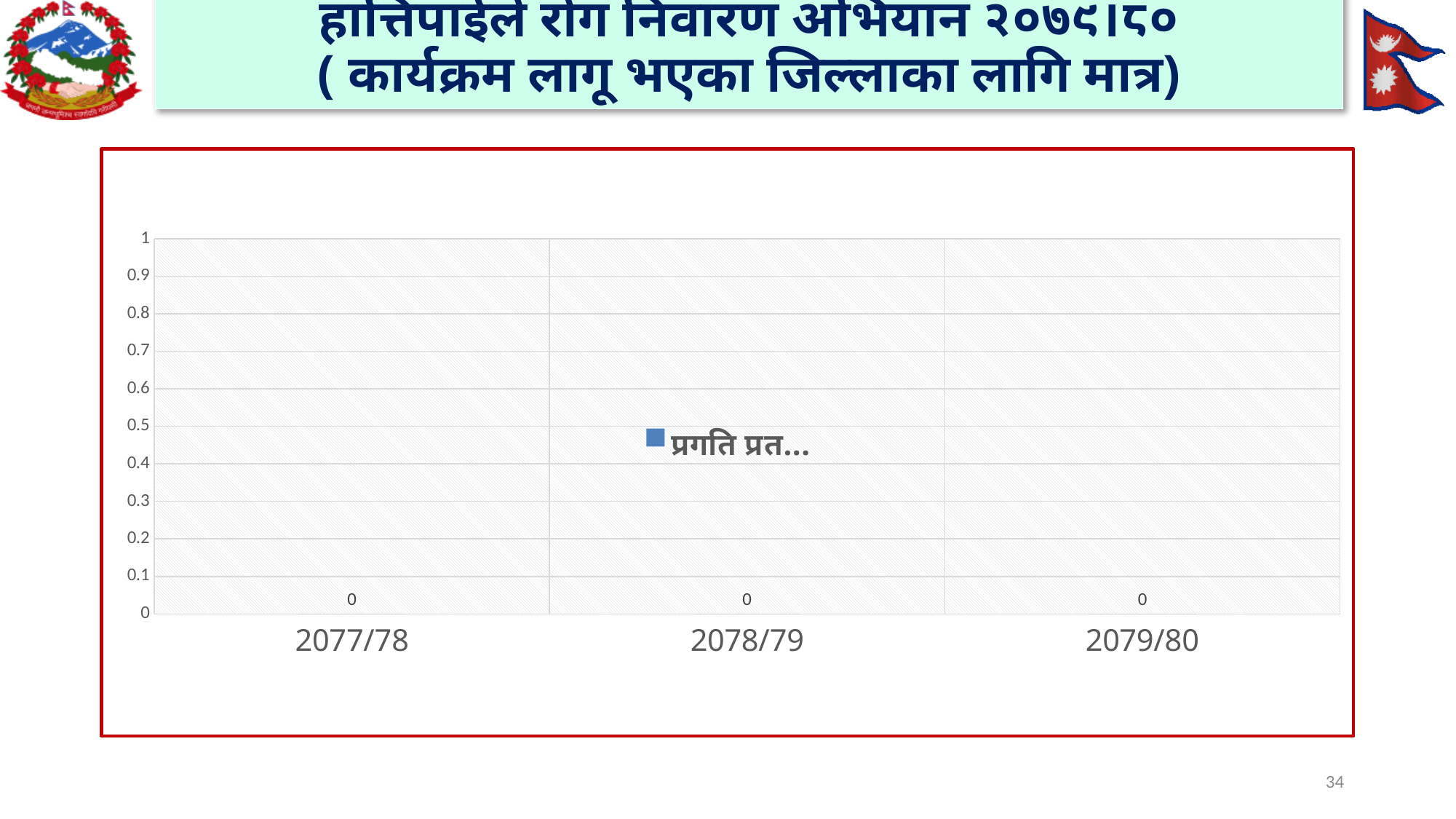
What is the value for 2077/78? 0 Do the values rise, fall, or stay the same from 2077/78 to 2079/80? stay the same How many categories are shown on the x axis of the chart? 3 What is the value for 2079/80? 0 What colour is the legend marker for the series in the chart? blue What is the difference between the values for 2077/78 and 2079/80? 0 What is the value for 2078/79? 0 What is the highest value shown on the y axis of the chart? 1 Is the value for 2078/79 greater or less than 0.5? less How many series does the chart's legend list? 1